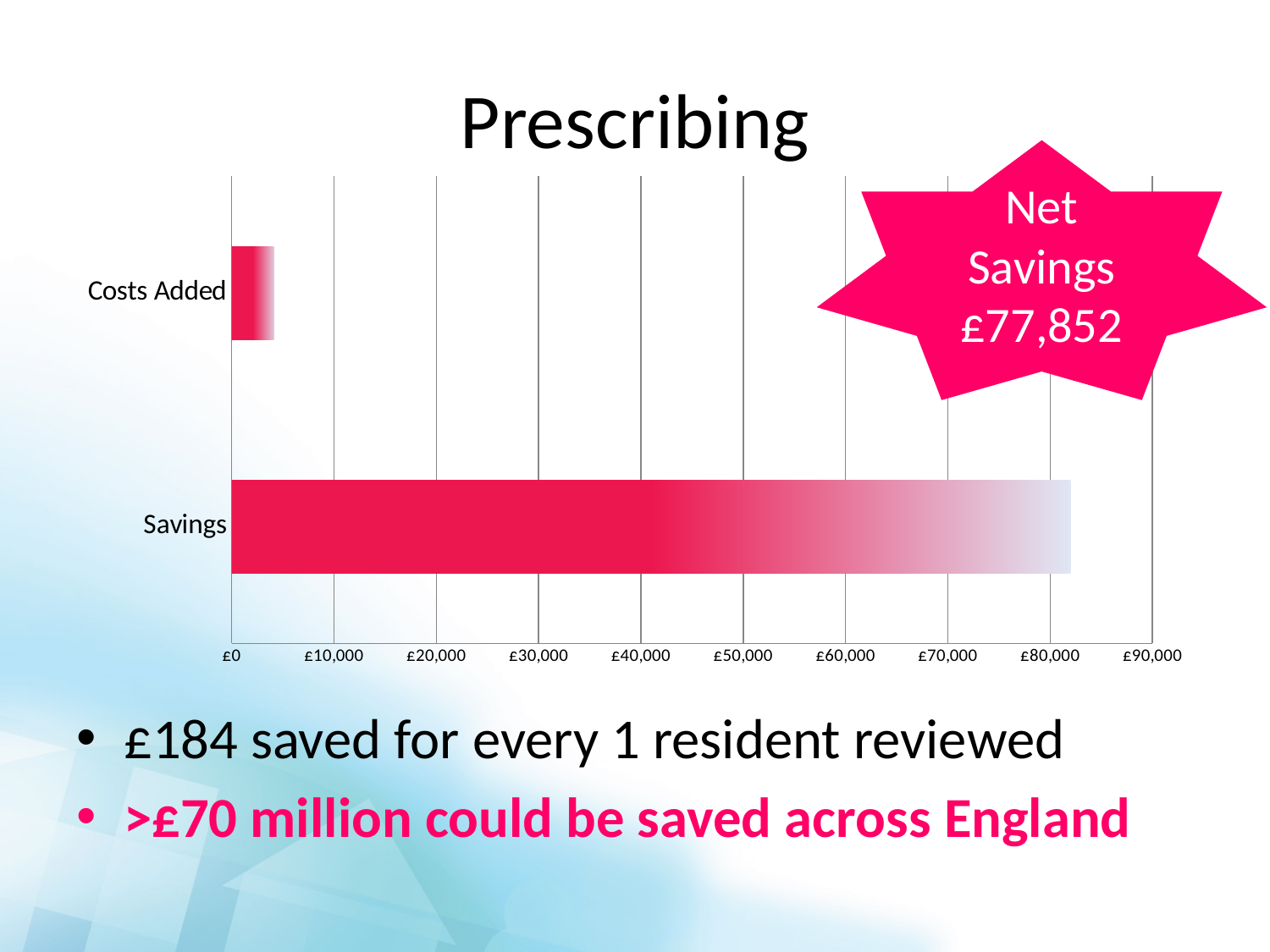
What kind of chart is shown on the slide? bar chart What is the title shown above the chart? Prescribing Is the value for Savings greater or less than £70,000? greater What is the highest value shown on the chart's horizontal axis? £90,000 Which category has the lowest value in the chart? Costs Added Is the value for Costs Added greater or less than £10,000? less Is the value for Costs Added greater or less than £20,000? less Which is larger, the value for Savings or the value for Costs Added? Savings Which category has the highest value in the chart? Savings How many categories are plotted in the chart? 2